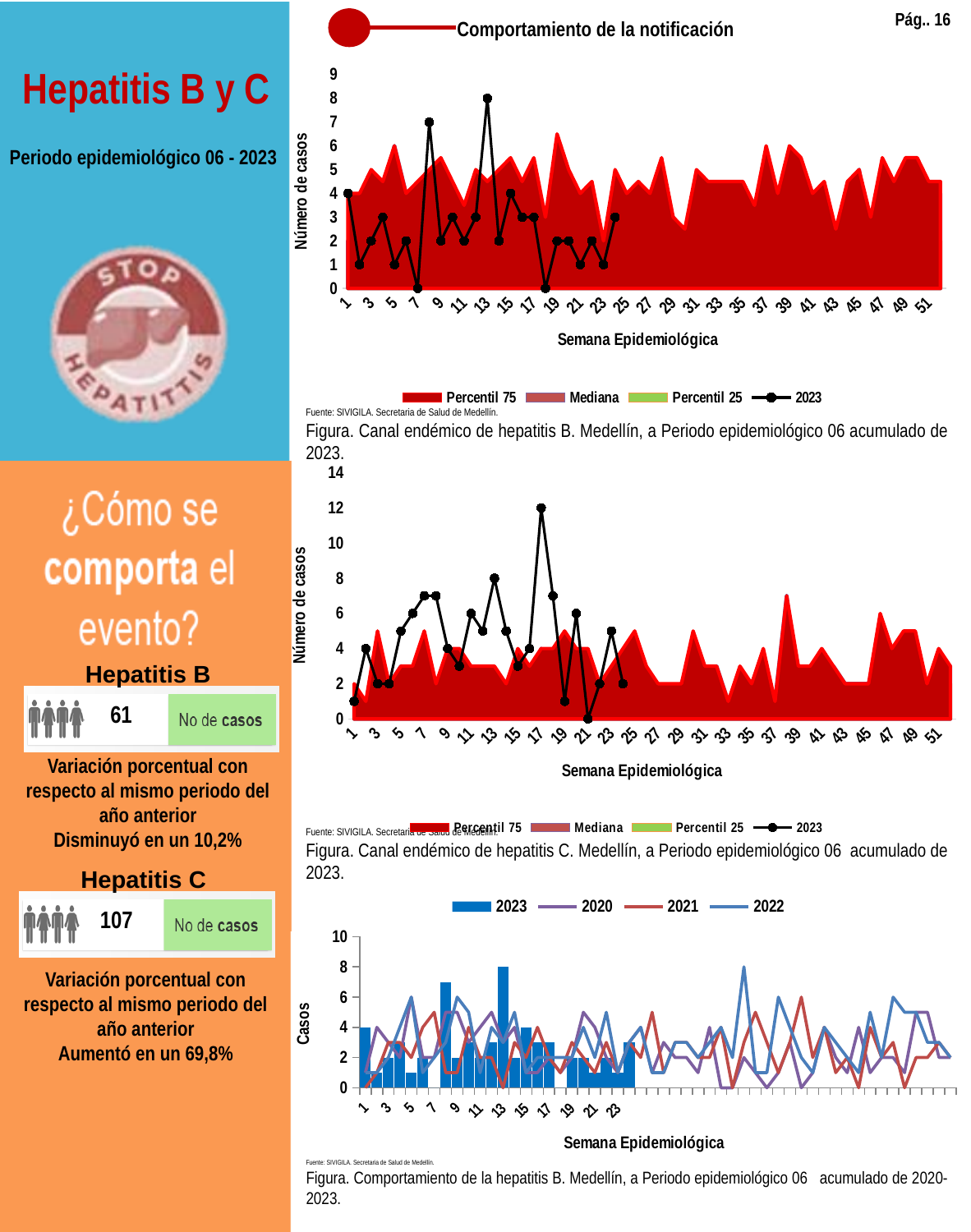
In the hepatitis B endemic channel chart (top chart), at which epidemiological week does the 2023 line reach its highest value? Week 13 In the hepatitis C endemic channel chart (middle chart), is the value of the 2023 line at week 21 greater or less than 2? less In the hepatitis C endemic channel chart (middle chart), what is the highest value of the 2023 line? 12 How many series does the legend of the hepatitis B endemic channel chart (top chart) list? 4 In the hepatitis C endemic channel chart (middle chart), which is larger: the 2023 value at week 17 or at week 13? Week 17 In the bottom chart (Comportamiento de la hepatitis B 2020-2023), what kind of chart is used for the 2023 series? Bar chart In the hepatitis B endemic channel chart (top chart), what is the value of the 2023 line at week 13? 8 In the bottom chart (Comportamiento de la hepatitis B 2020-2023), is the 2023 bar at week 13 greater or less than 6? greater What is the label of the x axis of the hepatitis C endemic channel chart (middle chart)? Semana Epidemiológica In the hepatitis B endemic channel chart (top chart), is the value of the 2023 line at week 8 greater or less than 5? greater In the hepatitis C endemic channel chart (middle chart), at which epidemiological week does the 2023 line reach its highest value? Week 17 How many series does the legend of the bottom chart (Comportamiento de la hepatitis B 2020-2023) list? 4